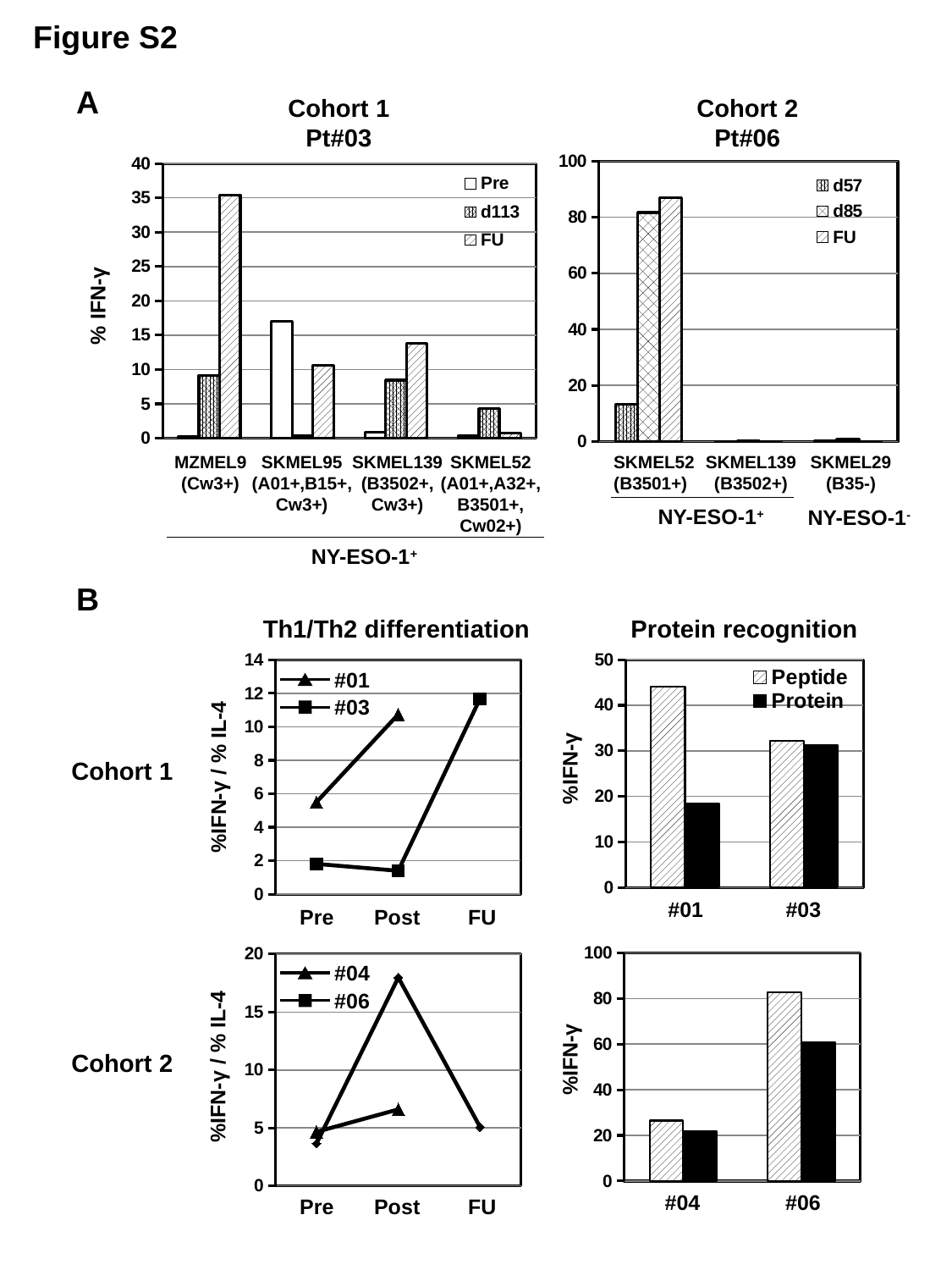
In the Cohort 1 Pt#03 chart, how many series does the legend list? 3 What kind of chart is the Cohort 1 Th1/Th2 differentiation chart? line chart In the Cohort 2 Th1/Th2 differentiation chart, does the #04 line rise or fall from Pre to Post? rise In the Cohort 1 Protein recognition chart, for #01, which is larger, Peptide or Protein? Peptide In the Cohort 1 Th1/Th2 differentiation chart, how many series does the legend list? 2 In the Cohort 2 Pt#06 chart, which cell line has the highest d85 value? SKMEL52 (B3501+) In the Cohort 1 Pt#03 chart, is the FU value for MZMEL9 (Cw3+) greater or less than 30? greater In the Cohort 1 Pt#03 chart, is the Pre value for SKMEL95 greater or less than 15? greater In the Cohort 1 Protein recognition chart, is the Peptide value for #01 greater or less than 40? greater In the Cohort 2 Pt#06 chart, how many cell lines are shown on the x axis? 3 In the Cohort 1 Pt#03 chart, which cell line has the highest FU value? MZMEL9 (Cw3+)